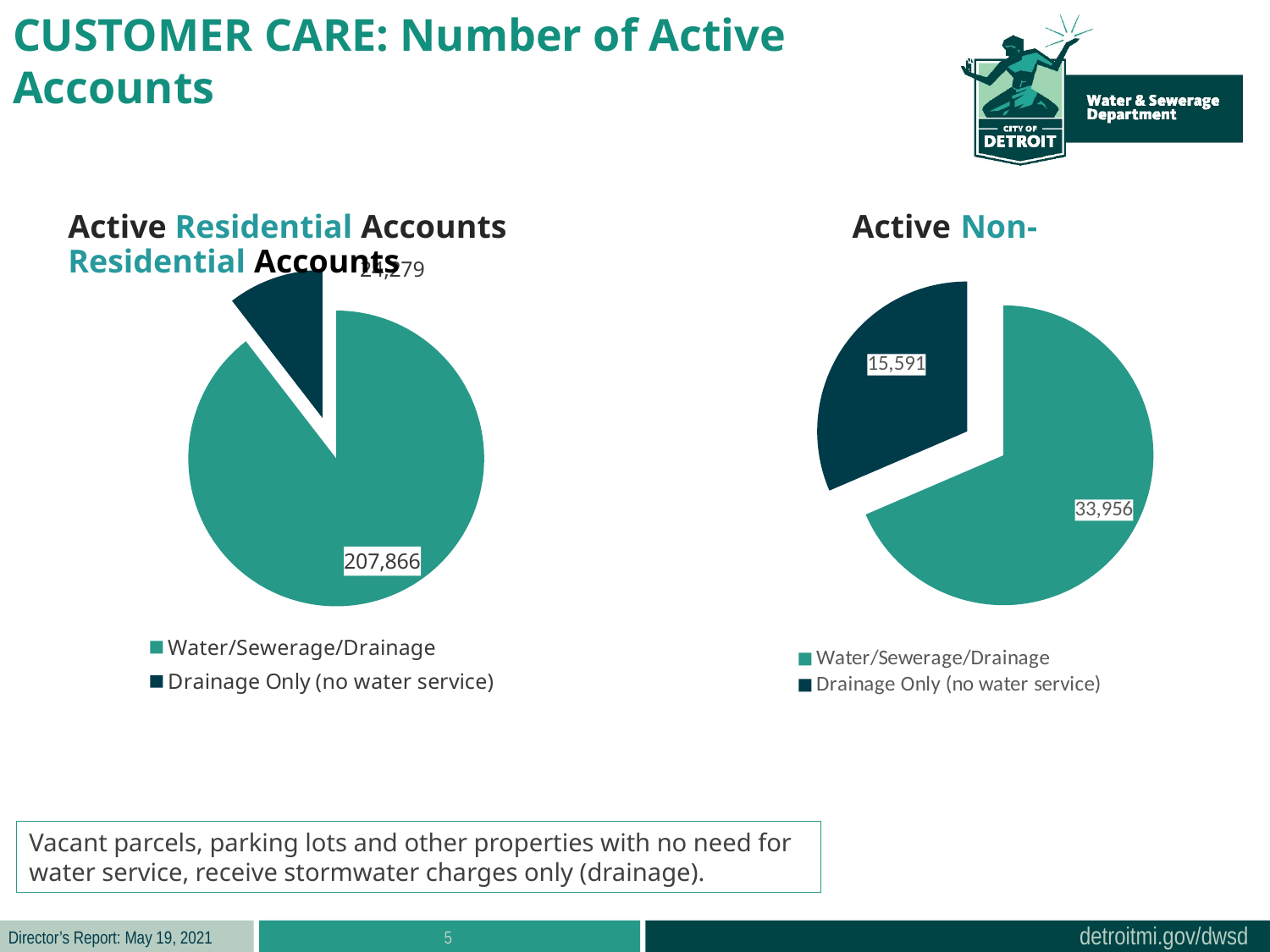
In the Active Non-Residential Accounts chart, what is the difference between Water/Sewerage/Drainage and Drainage Only (no water service)? 18,365 In the Active Residential Accounts chart, what is the value for Water/Sewerage/Drainage? 207,866 In the Active Non-Residential Accounts chart, which category is shown in the dark navy colour? Drainage Only (no water service) How many categories does the Active Non-Residential Accounts chart show? 2 Which is larger: Water/Sewerage/Drainage in the Active Residential Accounts chart or Water/Sewerage/Drainage in the Active Non-Residential Accounts chart? Active Residential Accounts What kind of chart is the Active Residential Accounts chart? Pie chart In the Active Non-Residential Accounts chart, which category has the largest slice? Water/Sewerage/Drainage In the Active Non-Residential Accounts chart, what is the value for Water/Sewerage/Drainage? 33,956 In the Active Non-Residential Accounts chart, what is the value for Drainage Only (no water service)? 15,591 In the Active Residential Accounts chart, which category has the smallest slice? Drainage Only (no water service) In the Active Non-Residential Accounts chart, what is the total of the two slices? 49,547 How many entries does the legend of the Active Residential Accounts chart list? 2